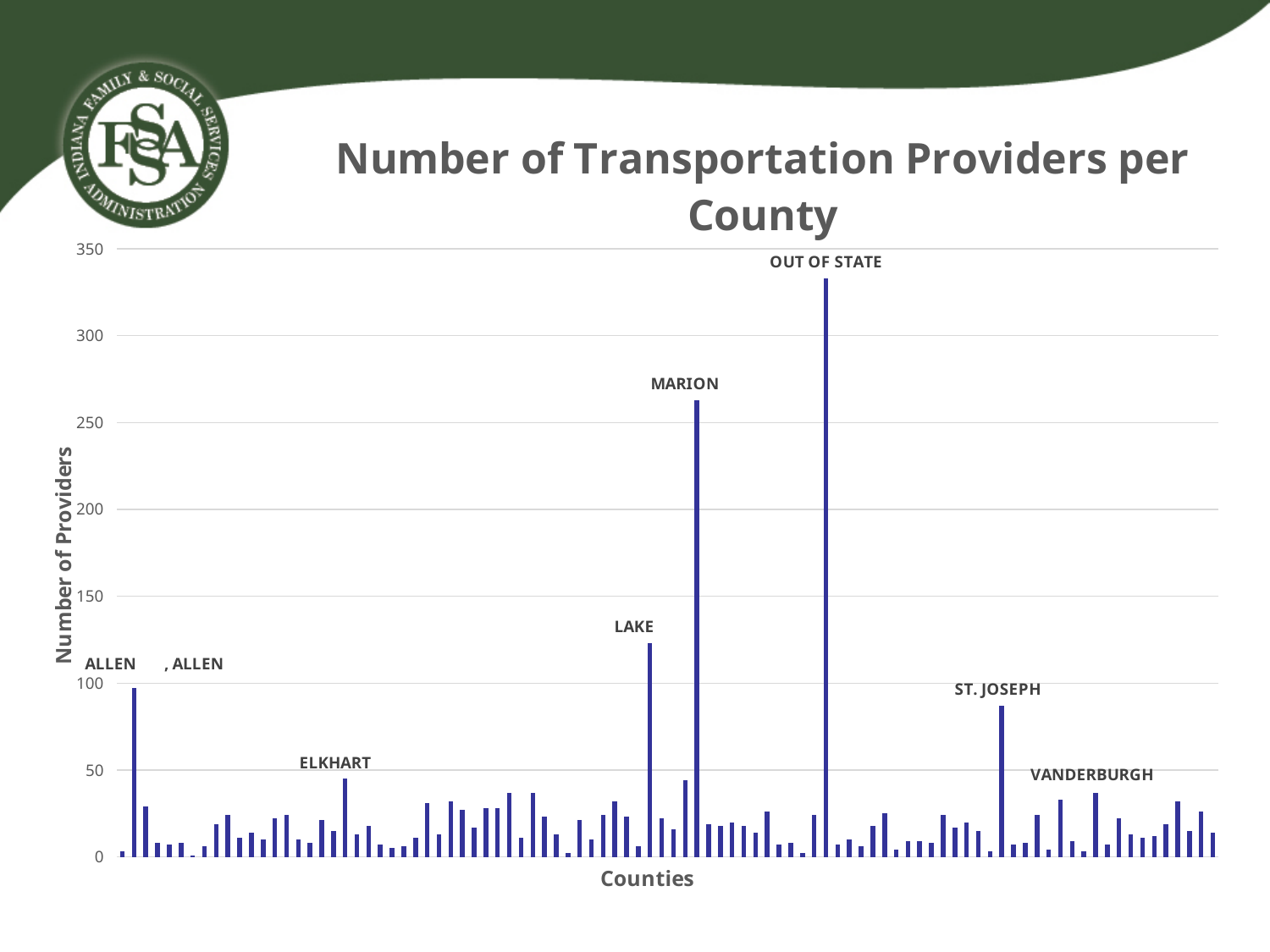
Is the value for MARION greater or less than 250? greater Is the value for ALLEN greater or less than 50? greater Which has more transportation providers, LAKE or ALLEN? LAKE Which has more transportation providers, MARION or LAKE? MARION Is the value for LAKE greater or less than 100? greater What is the label on the vertical axis of the chart? Number of Providers What kind of chart is shown on the slide? bar chart What is the title of the chart? Number of Transportation Providers per County Which labeled county or category has the highest number of transportation providers? OUT OF STATE